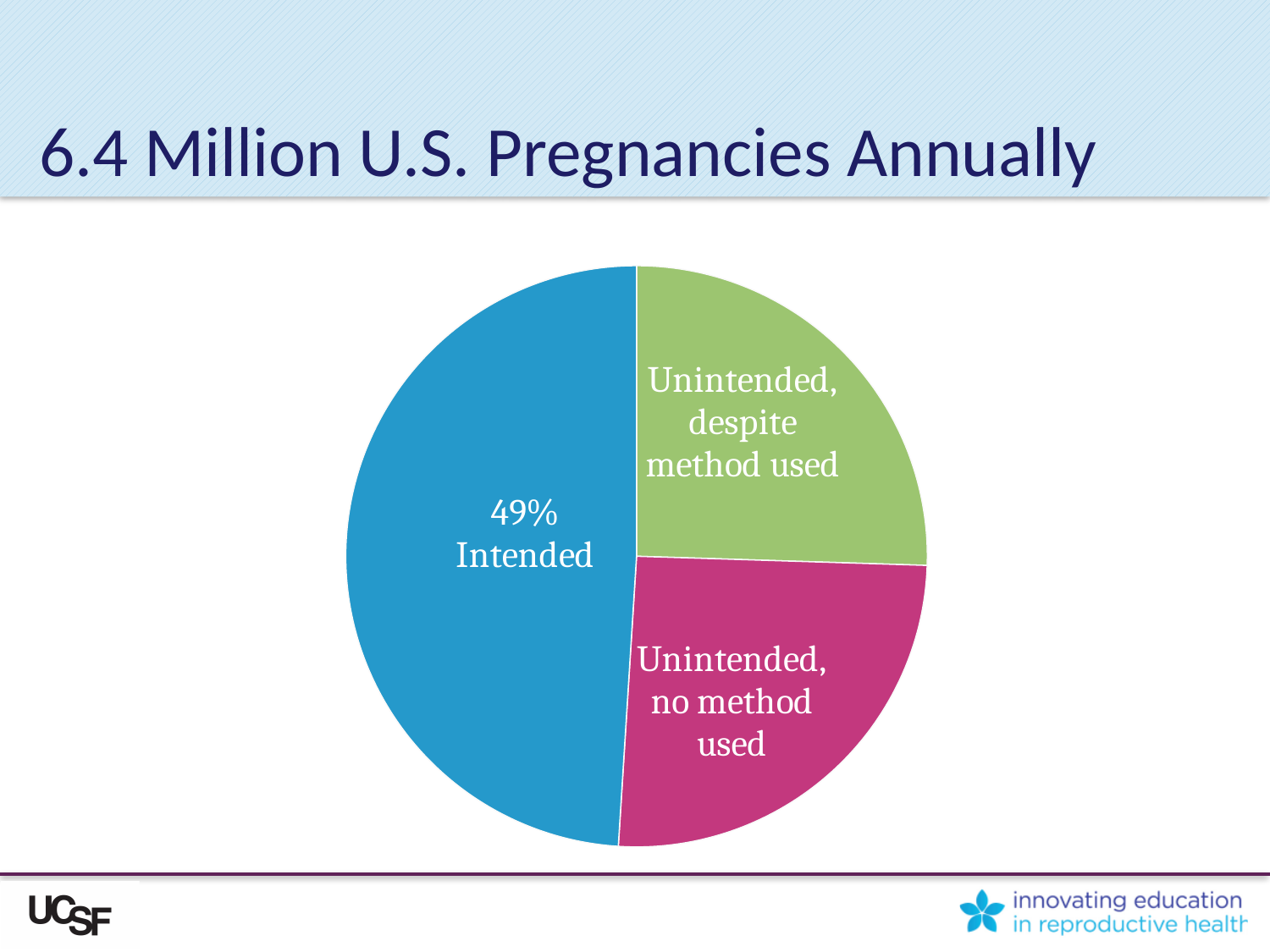
What is the title of the slide containing the pie chart? 6.4 Million U.S. Pregnancies Annually What colour is the Intended slice of the pie chart? blue Which slice of the pie chart is the largest? Intended How many slices does the pie chart have? 3 Is the share for 'Unintended, despite method used' greater or less than 50%? less What percentage of pregnancies does the pie chart show as Intended? 49% Is the share for 'Unintended, no method used' greater or less than 50%? less Which is larger: the Intended slice or the 'Unintended, no method used' slice? Intended What kind of chart is shown on the slide? pie chart Which is larger: the Intended slice or the 'Unintended, despite method used' slice? Intended What share of the pie does the Intended slice represent? 49%